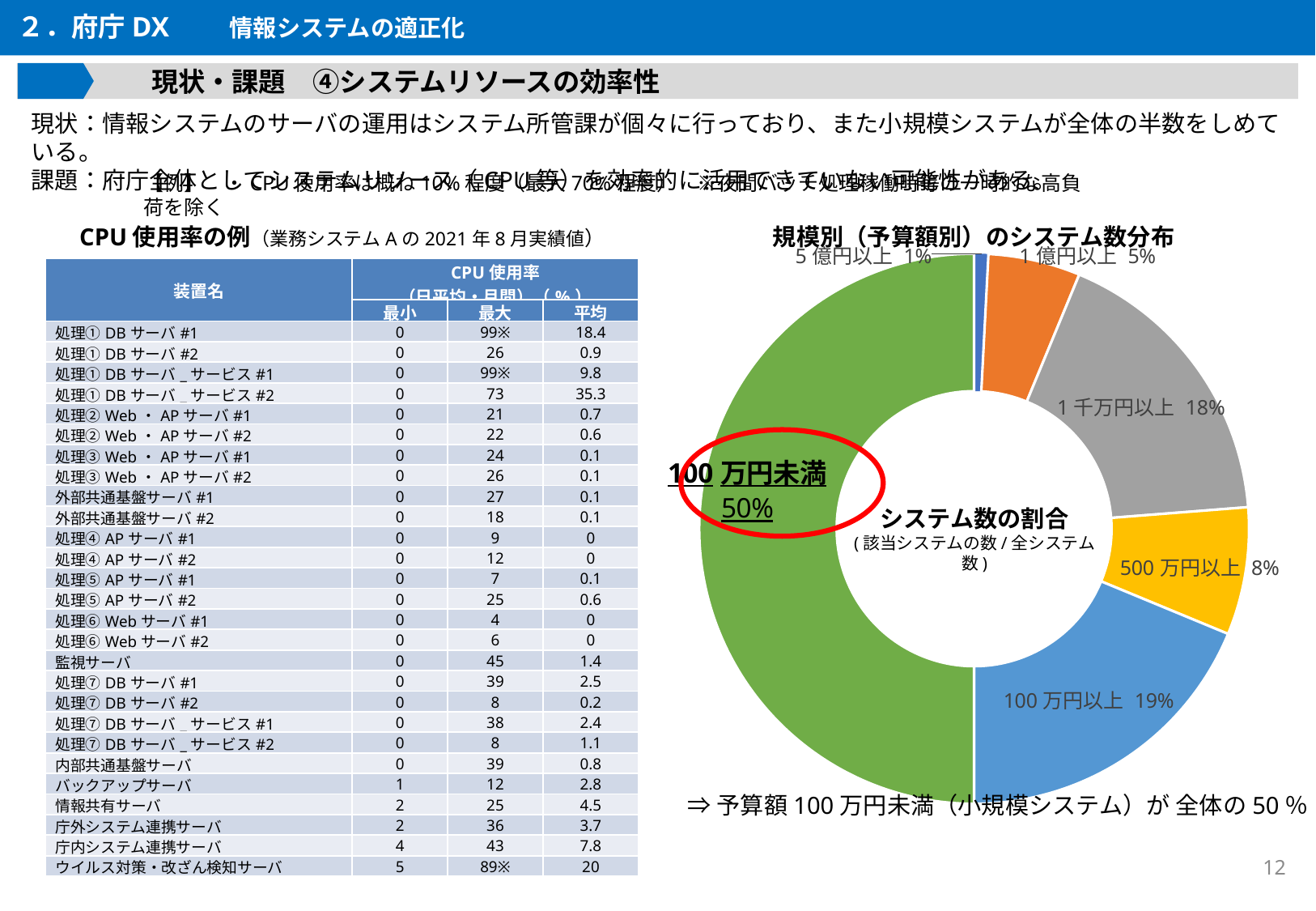
In the 規模別（予算額別）のシステム数分布 chart, what share of systems is 1千万円以上? 18% In the 規模別（予算額別）のシステム数分布 chart, what share of systems is 100万円未満? 50% In the 規模別（予算額別）のシステム数分布 chart, which budget category has the largest share? 100万円未満 In the 規模別（予算額別）のシステム数分布 chart, how many percentage points larger is the 100万円未満 share than the 100万円以上 share? 31 In the 規模別（予算額別）のシステム数分布 chart, what share of systems is 500万円以上? 8% In the 規模別（予算額別）のシステム数分布 chart, what share of systems is 100万円以上? 19% In the 規模別（予算額別）のシステム数分布 chart, which budget category has the smallest share? 5億円以上 How many budget categories are shown in the 規模別（予算額別）のシステム数分布 chart? 6 In the 規模別（予算額別）のシステム数分布 chart, what share of systems is 5億円以上? 1% In the 規模別（予算額別）のシステム数分布 chart, which is larger: the share for 1億円以上 or the share for 500万円以上? 500万円以上 In the 規模別（予算額別）のシステム数分布 chart, what colour is the 100万円未満 slice? Green What kind of chart is the 規模別（予算額別）のシステム数分布 chart? Doughnut chart